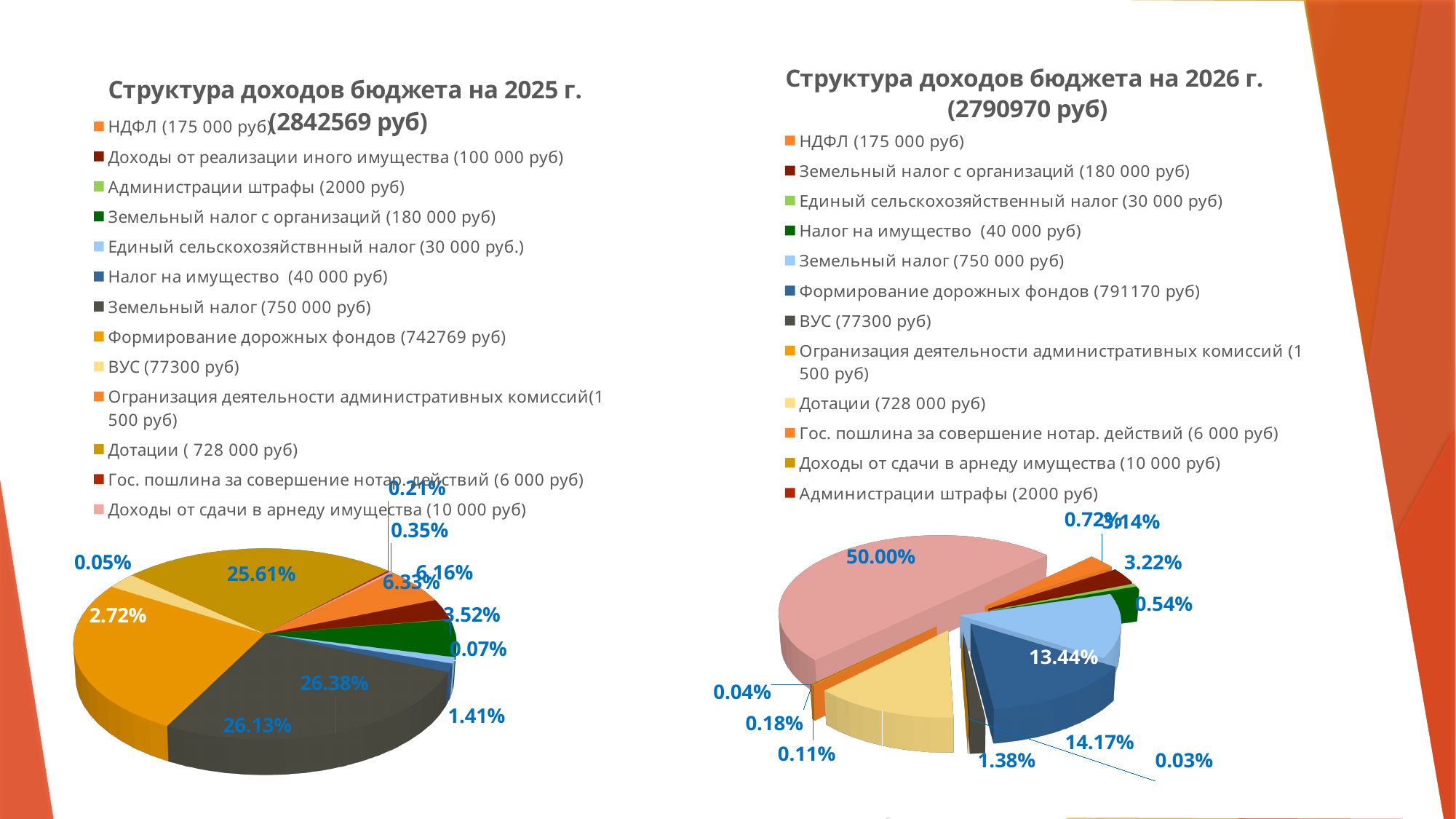
What kind of chart is used on the left side of the slide for the 2025 budget structure? Pie chart In the chart 'Структура доходов бюджета на 2025 г.', what share of the pie does the 'Земельный налог' slice have? 26.38% In the chart 'Структура доходов бюджета на 2026 г.', what amount does the legend give for 'Земельный налог'? 750 000 руб In the chart 'Структура доходов бюджета на 2026 г.', which slice is larger: 'Формирование дорожных фондов' (14.17%) or 'Земельный налог' (13.44%)? Формирование дорожных фондов In the chart 'Структура доходов бюджета на 2025 г.', how many categories does the legend list? 13 In the chart 'Структура доходов бюджета на 2025 г.', what is the total budget income shown in the title? 2842569 руб In the chart 'Структура доходов бюджета на 2025 г.', what share of the pie does the 'Дотации' slice have? 25.61% In the chart 'Структура доходов бюджета на 2025 г.', what share of the pie does the 'Формирование дорожных фондов' slice have? 26.13% In the chart 'Структура доходов бюджета на 2026 г.', what is the largest percentage label shown on the pie? 50.00% In the chart 'Структура доходов бюджета на 2025 г.', what is the difference between the 'Земельный налог' share and the 'Дотации' share? 0.77% In the chart 'Структура доходов бюджета на 2026 г.', what is the total budget income shown in the title? 2790970 руб In the chart 'Структура доходов бюджета на 2026 г.', how many categories does the legend list? 12